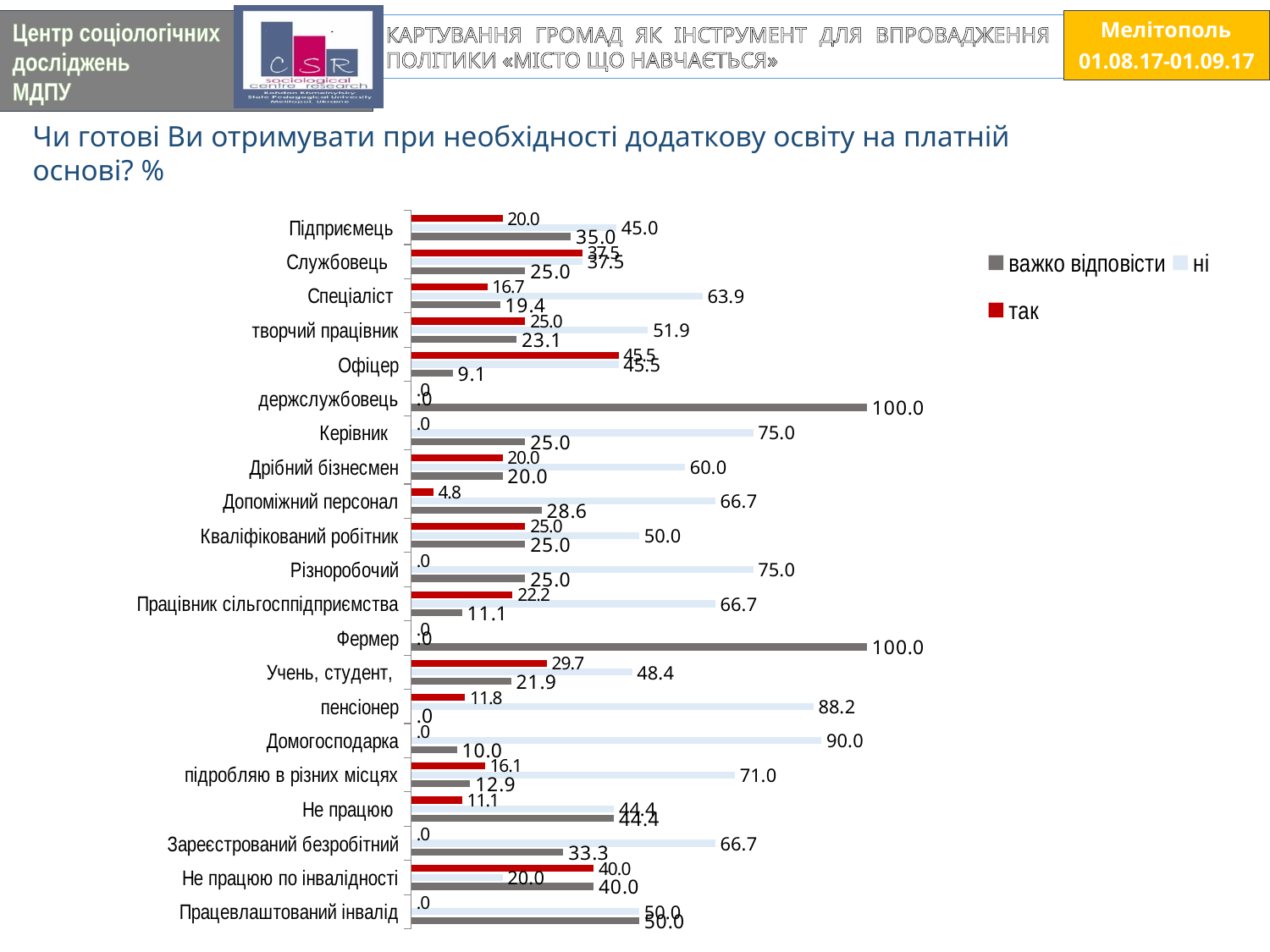
How many occupation categories are plotted on the chart? 21 What is the difference between the "ні" value for Домогосподарка and the "ні" value for пенсіонер? 1.8 Which is larger for Дрібний бізнесмен: the "ні" value or the "так" value? ні How many series does the legend list? 3 What is the value of "ні" for пенсіонер? 88.2 What is the value of "ні" for Спеціаліст? 63.9 Which category has the highest value for "так"? Офіцер Which category has the highest value for "ні"? Домогосподарка What kind of chart is shown on the slide? bar chart What is the value of "важко відповісти" for Допоміжний персонал? 28.6 Which colour represents the "так" series in the chart? red What is the value of "так" for Офіцер? 45.5